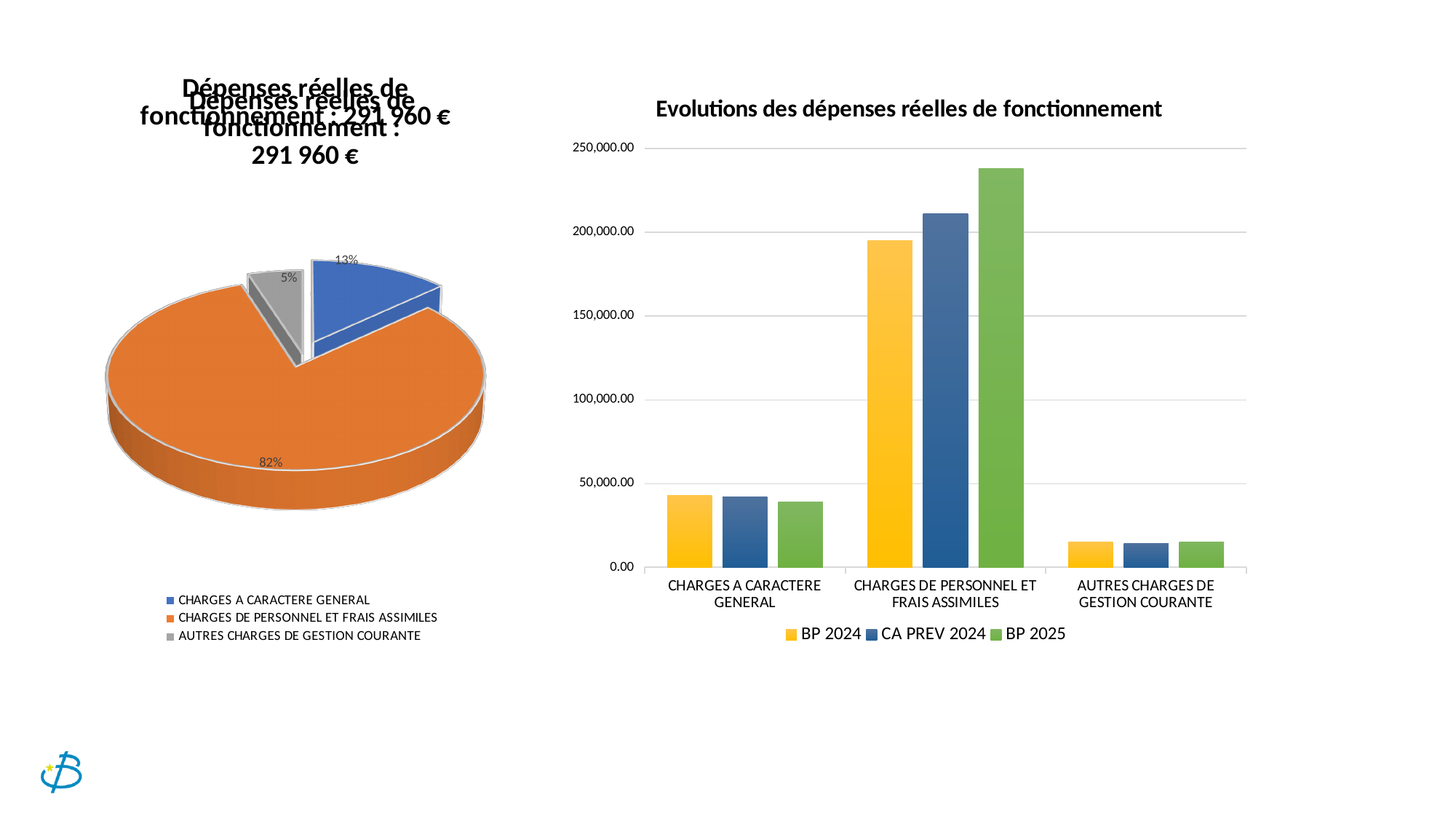
In the chart 'Evolutions des dépenses réelles de fonctionnement', is the BP 2024 value for CHARGES A CARACTERE GENERAL greater or less than 50,000.00? less In the pie chart on the left, what share is shown for AUTRES CHARGES DE GESTION COURANTE? 5% In the pie chart on the left, what share is shown for CHARGES A CARACTERE GENERAL? 13% In the chart 'Evolutions des dépenses réelles de fonctionnement', which series is shown in green in the legend? BP 2025 In the pie chart on the left, how many slices are there? 3 What kind of chart is 'Evolutions des dépenses réelles de fonctionnement'? bar chart In the chart 'Evolutions des dépenses réelles de fonctionnement', is the BP 2025 value for CHARGES DE PERSONNEL ET FRAIS ASSIMILES greater or less than 200,000.00? greater In the pie chart on the left, what share is shown for CHARGES DE PERSONNEL ET FRAIS ASSIMILES? 82% In the chart 'Evolutions des dépenses réelles de fonctionnement', which category has the highest bars? CHARGES DE PERSONNEL ET FRAIS ASSIMILES In the chart 'Evolutions des dépenses réelles de fonctionnement', for CHARGES DE PERSONNEL ET FRAIS ASSIMILES, which is larger: BP 2024 or BP 2025? BP 2025 In the chart 'Evolutions des dépenses réelles de fonctionnement', how many series does the legend list? 3 In the pie chart on the left, which category has the smallest slice? AUTRES CHARGES DE GESTION COURANTE